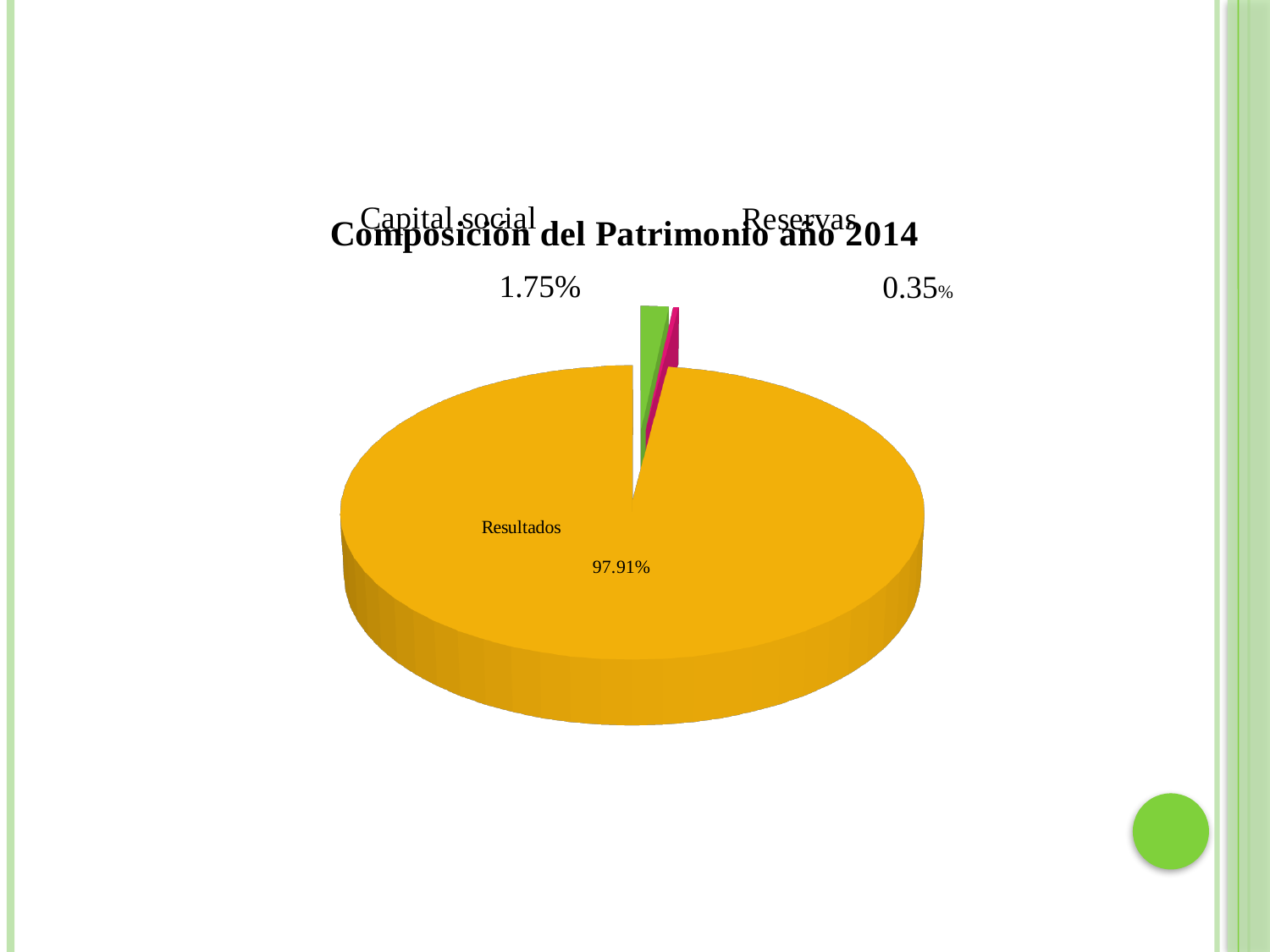
Which category has the largest slice of the pie? Resultados What is the difference in percentage points between Resultados and Capital social? 96.16 What type of chart is shown on the slide? Pie chart Which is larger, the share for Capital social or the share for Reservas? Capital social What share of the pie does Reservas represent? 0.35% What colour is the Resultados slice? Orange Which category has the smallest slice of the pie? Reservas How many slices does the pie chart have? 3 What is the difference in percentage points between Capital social and Reservas? 1.40 What share of the pie does Resultados represent? 97.91% What is the title of the chart? Composición del Patrimonio año 2014 What share of the pie does Capital social represent? 1.75%